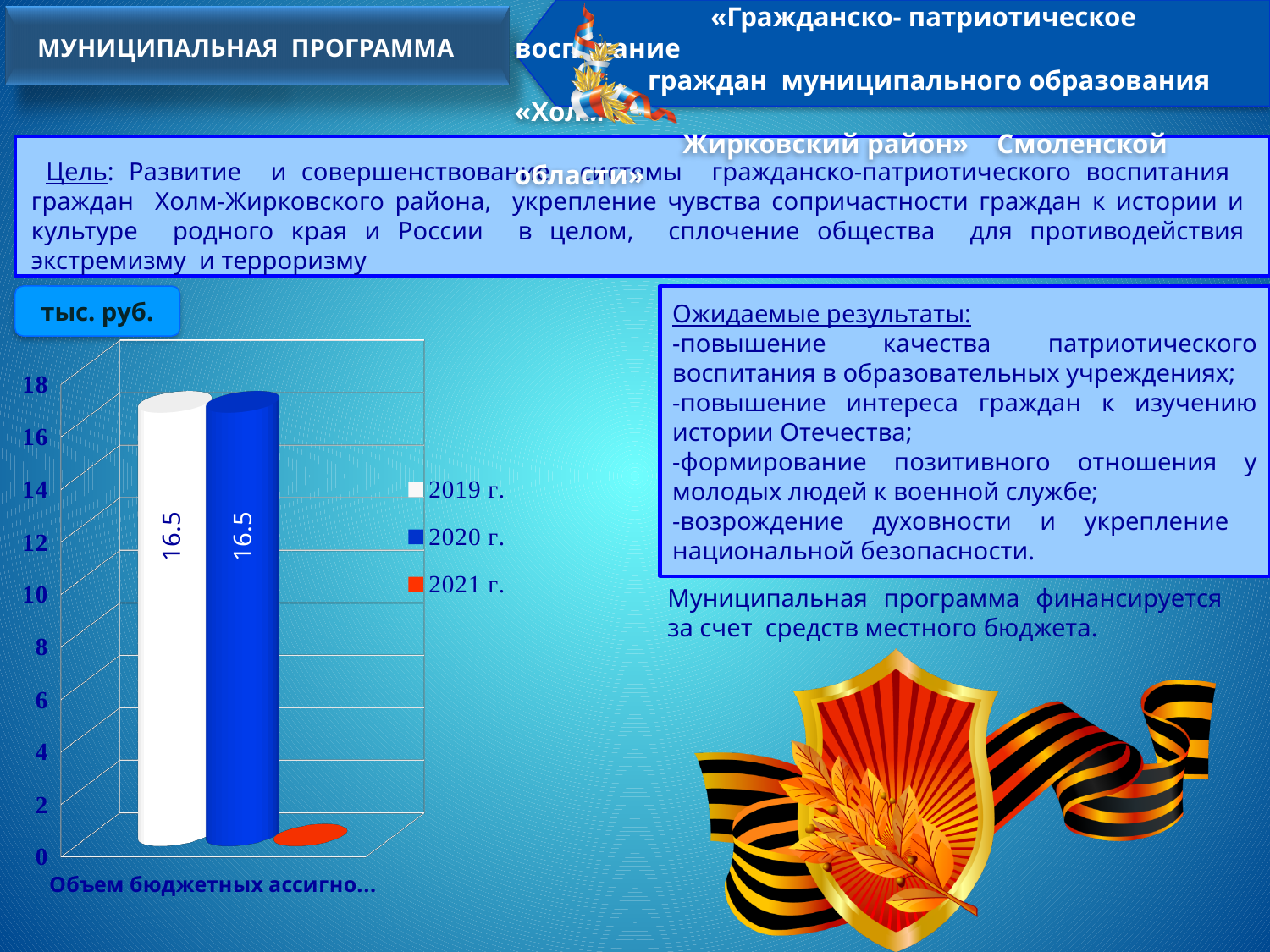
What is the value for 2020 г. in the chart? 16.5 Which series has the lowest value in the chart? 2021 г. Is the value for 2019 г. greater or less than 16? greater What is the difference between the values for 2019 г. and 2020 г.? 0 Is the value for 2021 г. greater or less than 2? less What is the value for 2019 г. in the chart? 16.5 What colour represents 2020 г. in the legend? blue What is the highest value shown on the vertical axis? 18 Is the value for 2020 г. greater or less than 18? less How many series does the chart legend list? 3 What unit is indicated for the chart values? тыс. руб. What kind of chart is shown on the slide? bar chart